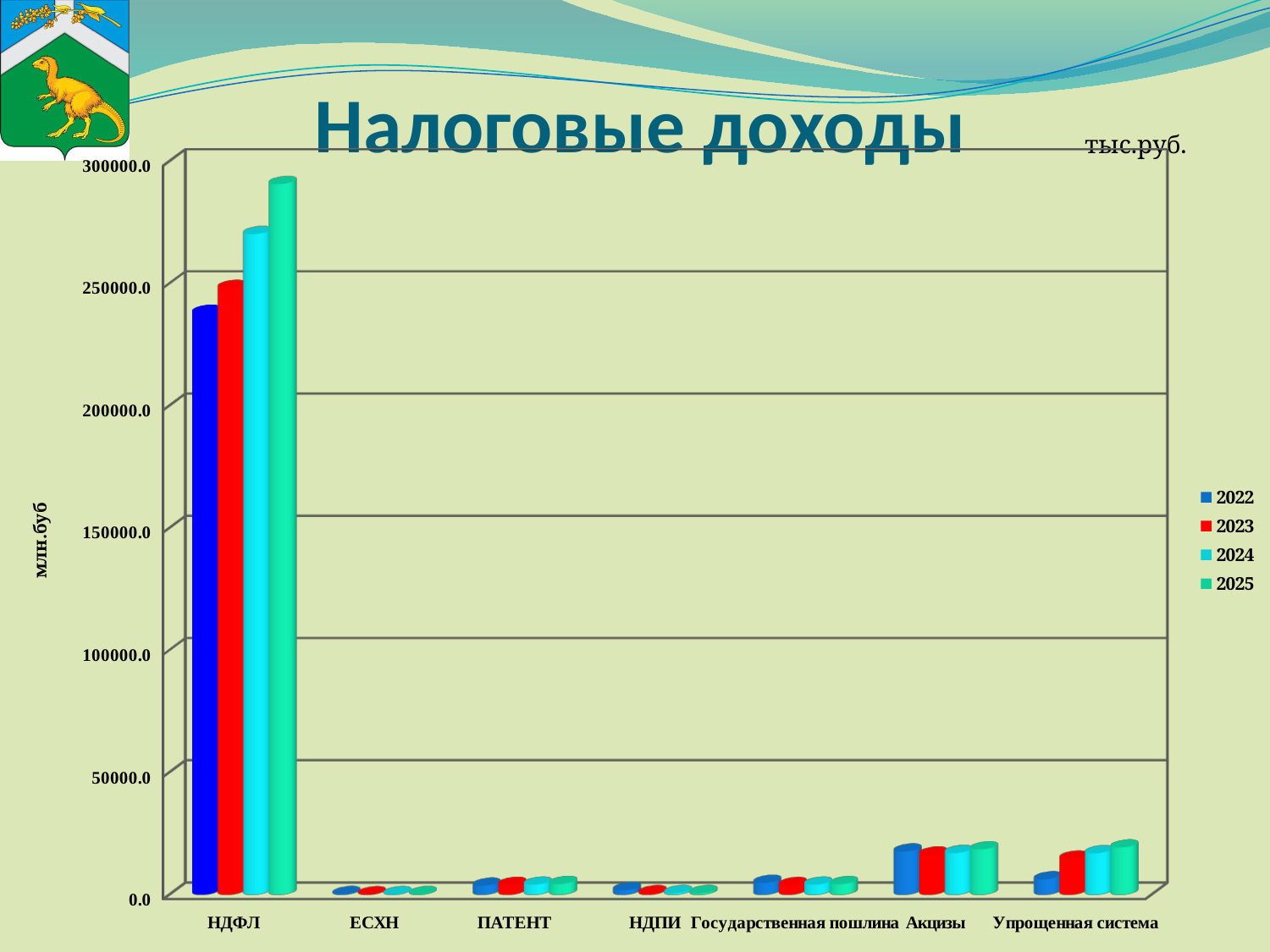
Is the value for Акцизы in 2022 greater or less than 50000.0? less What kind of chart is shown on the slide? bar chart How many categories are shown on the x axis of the chart? 7 Do the values for НДФЛ rise or fall from 2022 to 2025? rise Which category has the highest values in the chart? НДФЛ Which series is shown in red in the legend? 2023 Which is larger for НДФЛ: the 2022 value or the 2025 value? 2025 Is the value for НДФЛ in 2025 greater or less than 250000.0? greater What is the title of the chart? Налоговые доходы How many series does the legend list? 4 Which is larger in 2022: Акцизы or ПАТЕНТ? Акцизы Is the value for НДФЛ in 2022 greater or less than 250000.0? less